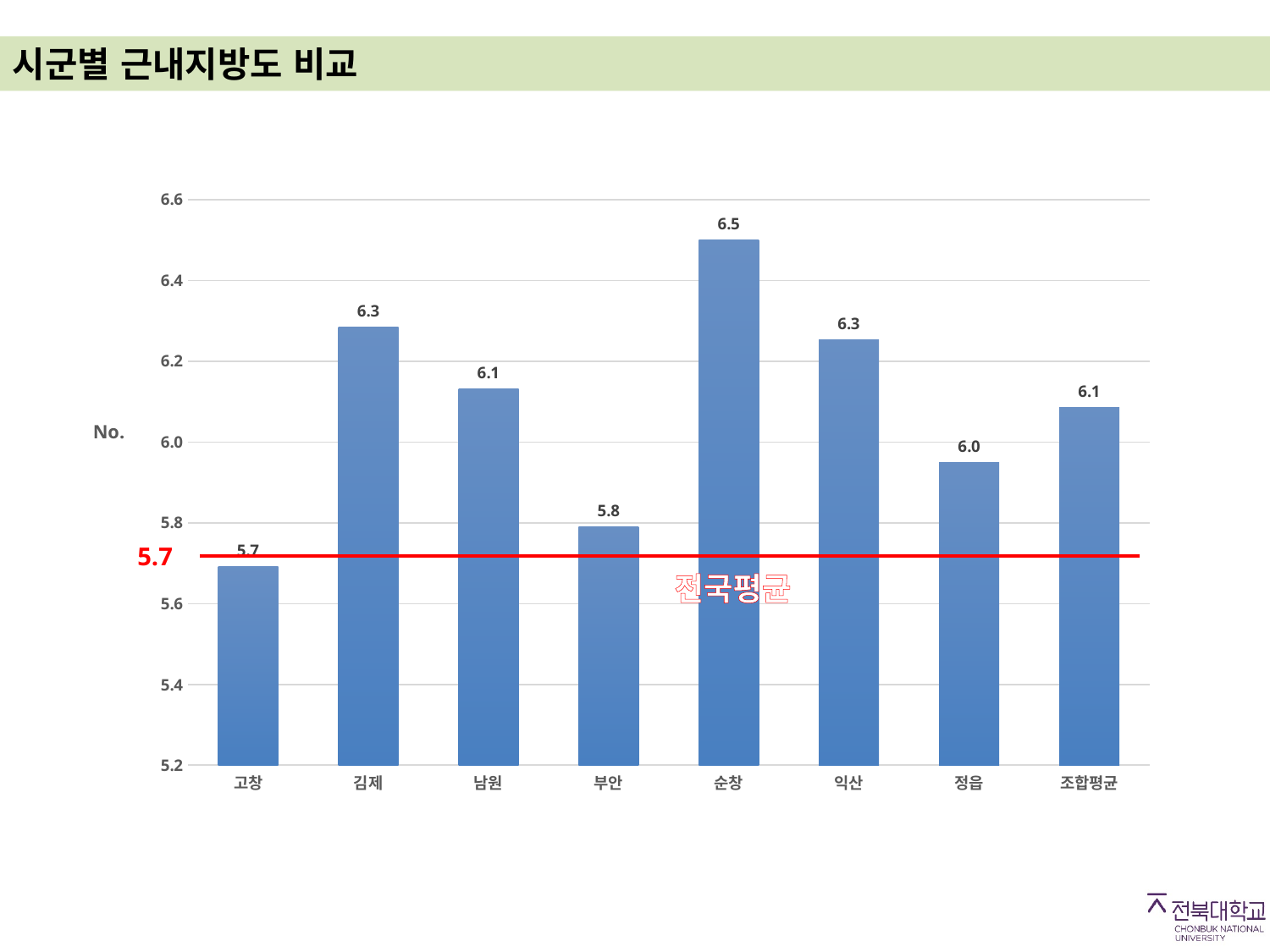
What kind of chart is shown on the slide? bar chart What value does the red horizontal line labelled 전국평균 mark? 5.7 Which category has the highest value? 순창 What is the value for 순창? 6.5 Is the value for 부안 greater or less than 6.0? less How many categories are shown on the x axis? 8 Which category has the lowest value? 고창 What is the value for 부안? 5.8 Which is larger, the value for 김제 or the value for 부안? 김제 What is the value for 고창? 5.7 What is the difference between the values for 순창 and 고창? 0.8 What is the value for 조합평균? 6.1